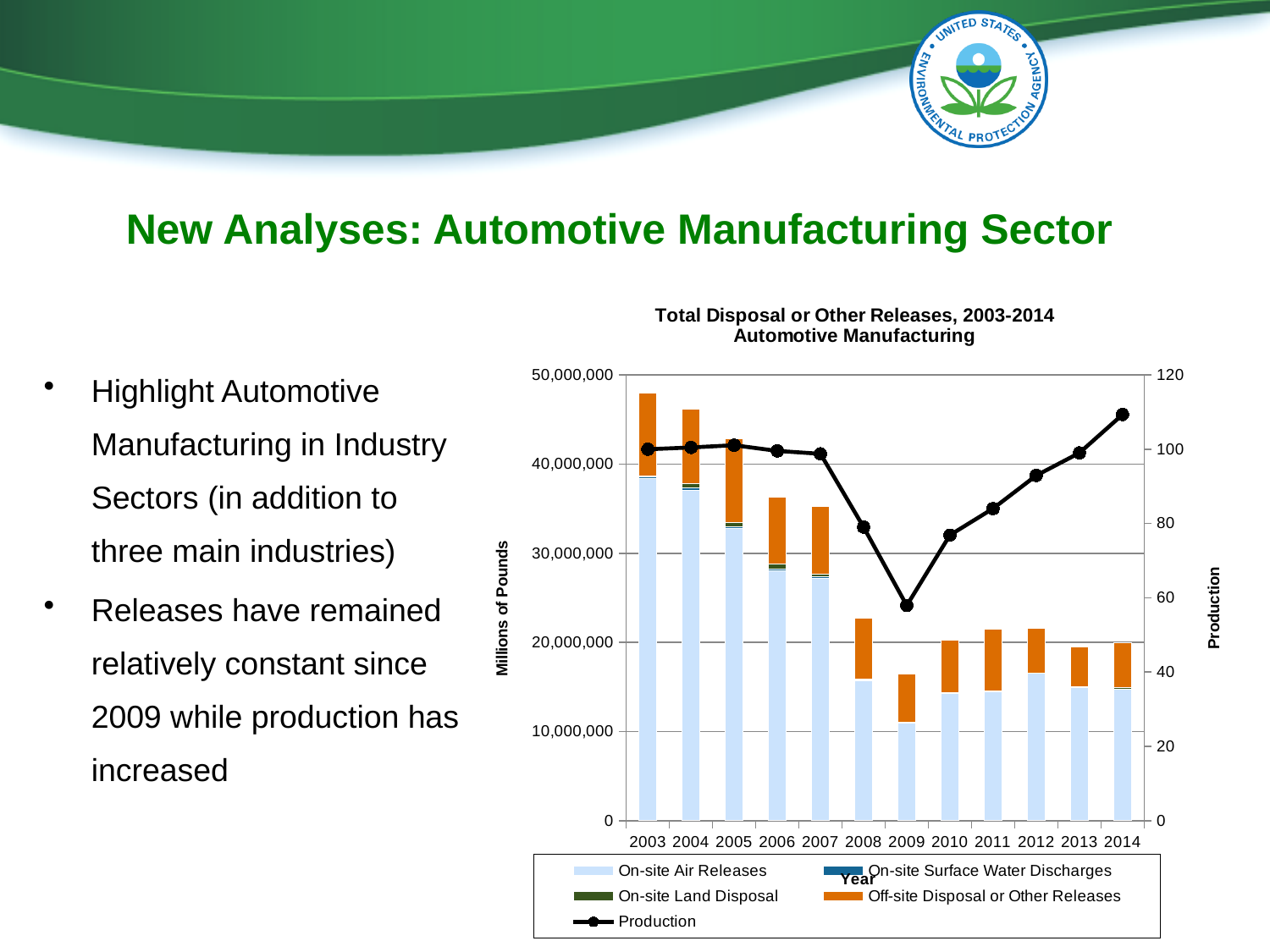
In which year is the Production line at its lowest? 2009 How many years are shown on the x axis of the chart? 12 Is the Production value for 2014 greater or less than 100? greater Is the total stacked bar for 2003 greater or less than 40,000,000? greater Which year has the tallest stacked bar of total disposal or other releases? 2003 How many series does the chart's legend list? 5 What kind of chart is shown on the slide? A combined stacked bar and line chart Which year has the shortest stacked bar of total disposal or other releases? 2009 Does the Production line rise or fall from 2009 to 2014? rise What is the title of the chart? Total Disposal or Other Releases, 2003-2014 Automotive Manufacturing Which series is plotted as a line rather than as stacked bars? Production In which year is the Production line at its highest? 2014